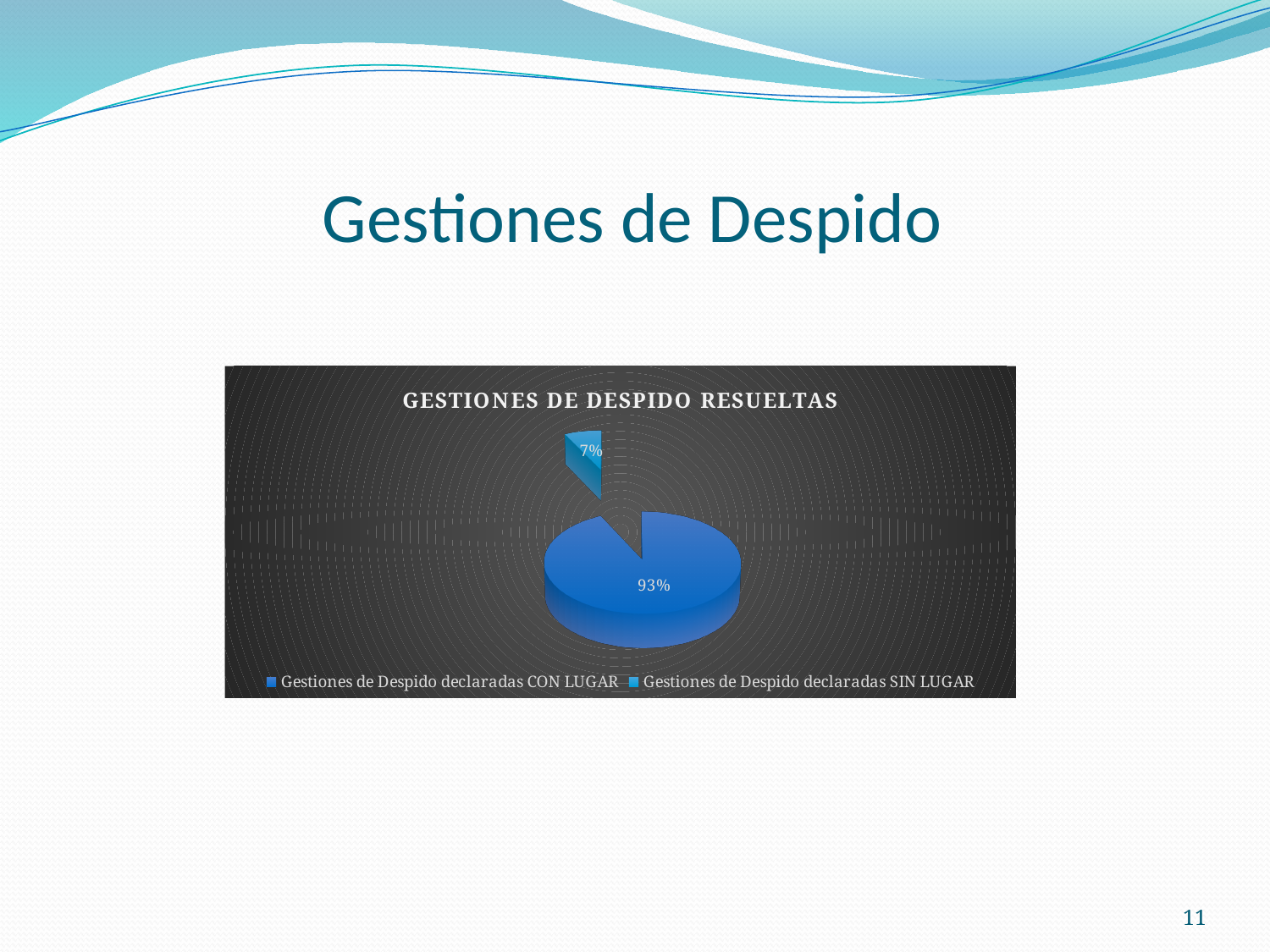
What share of the pie does the SIN LUGAR slice represent? 7% Which category has the largest slice of the pie? Gestiones de Despido declaradas CON LUGAR What is the difference in percentage points between the CON LUGAR slice and the SIN LUGAR slice? 86 What percentage of the pie is labelled for Gestiones de Despido declaradas SIN LUGAR? 7% How many entries does the legend list? 2 Which category has the smallest slice of the pie? Gestiones de Despido declaradas SIN LUGAR What percentage of the pie is labelled for Gestiones de Despido declaradas CON LUGAR? 93% How many slices does the pie chart have? 2 What kind of chart is shown on the slide? pie chart What is the total of the two percentages shown on the pie? 100% What is the title of the chart? GESTIONES DE DESPIDO RESUELTAS Which is larger, the slice for declaradas CON LUGAR or the slice for declaradas SIN LUGAR? Gestiones de Despido declaradas CON LUGAR